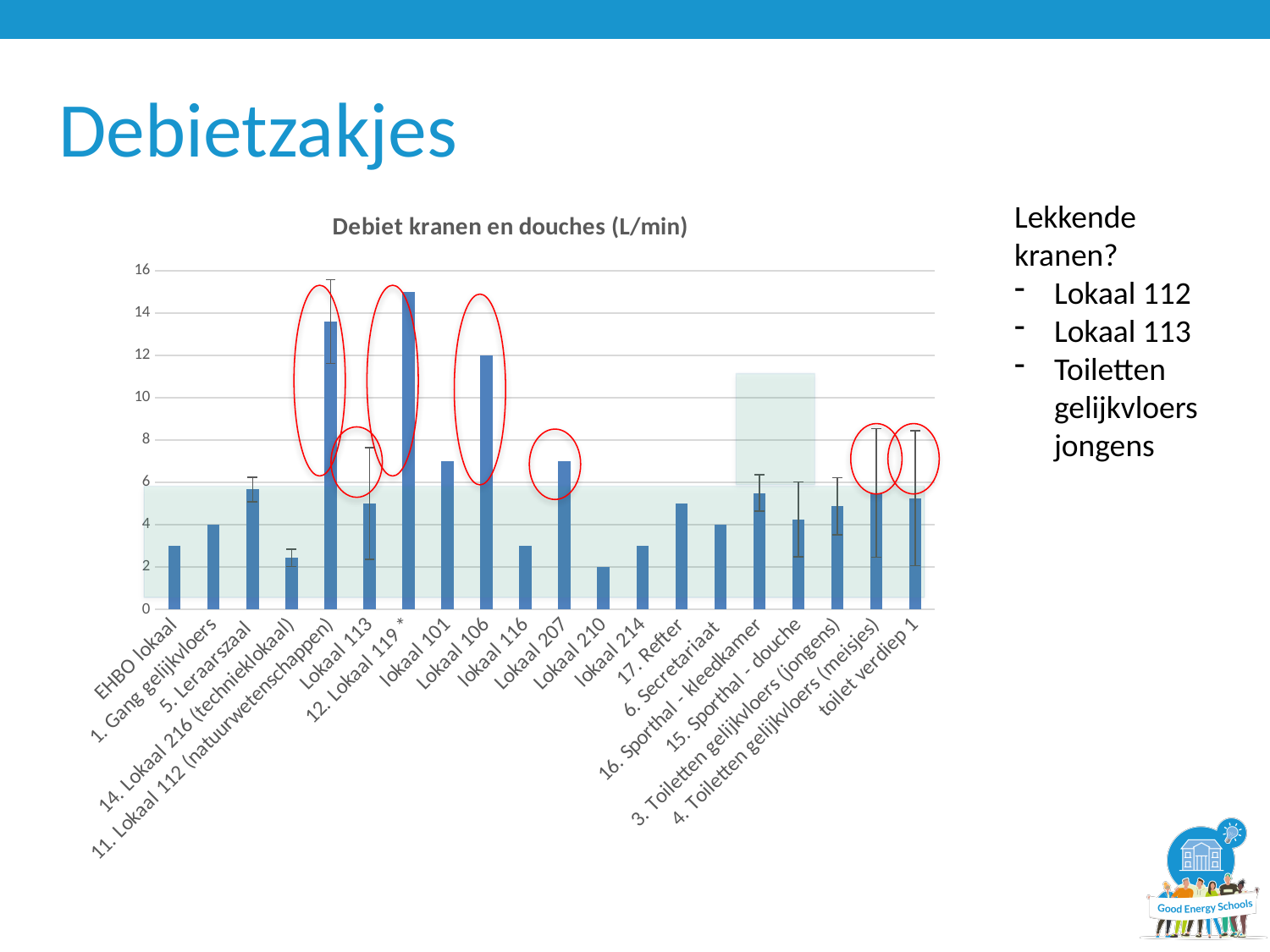
Which category has the lowest value in the chart? Lokaal 210 How many categories are plotted along the x axis of the chart? 20 Is the value for 11. Lokaal 112 (natuurwetenschappen) greater or less than 12? greater Which has the larger value, 12. Lokaal 119 * or 11. Lokaal 112 (natuurwetenschappen)? 12. Lokaal 119 * Which has the larger value, Lokaal 106 or lokaal 101? Lokaal 106 Is the value for Lokaal 207 greater or less than 6? greater Is the value for Lokaal 113 greater or less than 6? less Which category has the highest value in the chart? 12. Lokaal 119 * What is the title of the chart? Debiet kranen en douches (L/min) What is the value for lokaal 210? 2 What type of chart is shown on the slide? bar chart What is the value for Lokaal 106? 12